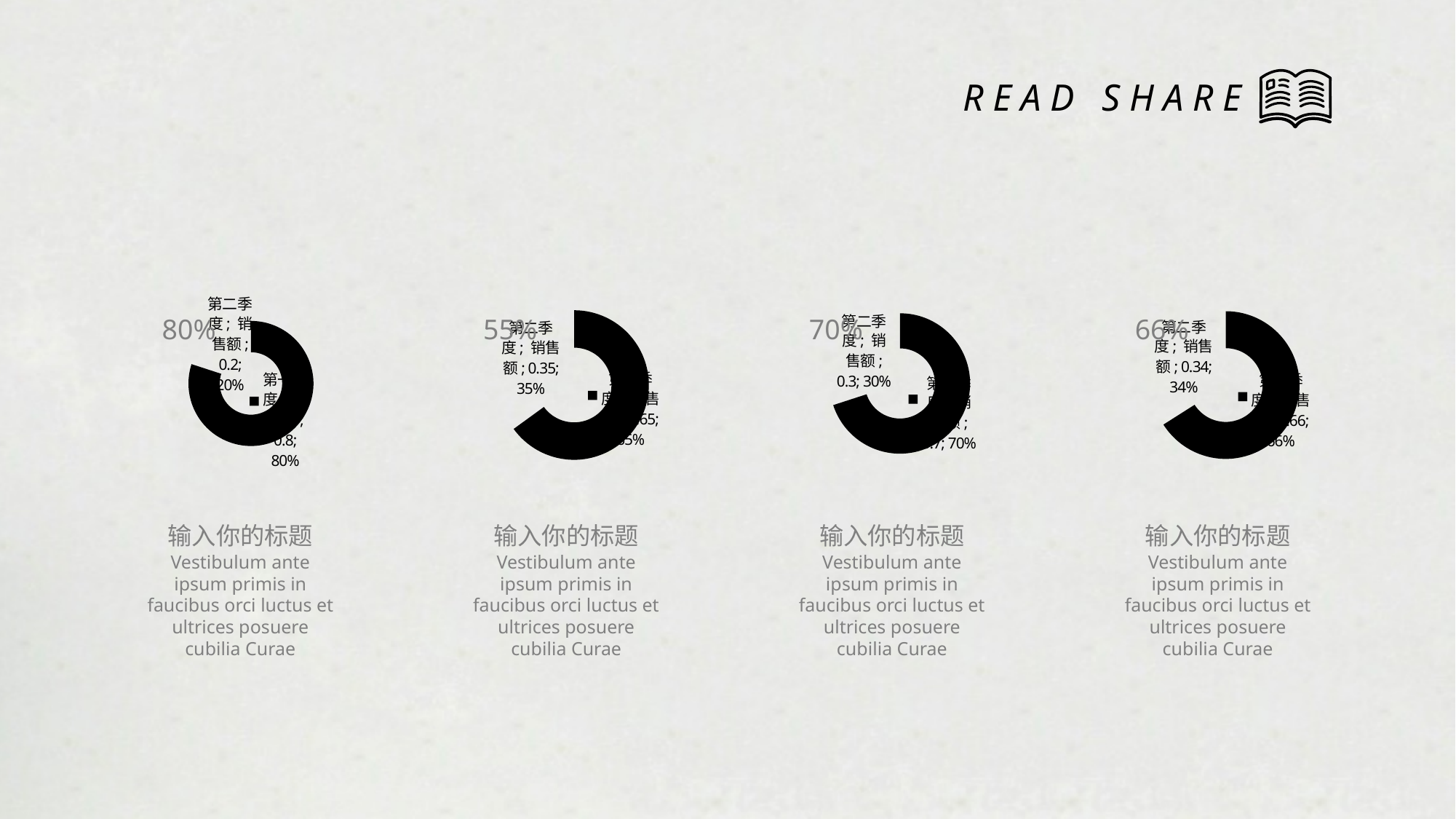
In the third chart from the left, what is the difference between the 第一季度 and 第二季度 percentages? 40% In the third chart from the left, what percentage is shown for 第二季度? 30% In the third chart from the left, what percentage is shown for 第一季度? 70% How many doughnut charts are shown on the slide? 4 How many slices does the leftmost doughnut chart have? 2 In the leftmost chart, what percentage is shown for 第一季度? 80% In the leftmost chart, what percentage is shown for 第二季度? 20% What large percentage label is printed next to the leftmost chart? 80% In the leftmost chart, which slice is larger, 第一季度 or 第二季度? 第一季度 In the rightmost chart, what percentage is shown for 第二季度? 34% In the second chart from the left, what percentage is shown for 第二季度? 35% What kind of chart is the leftmost chart on the slide? Doughnut chart